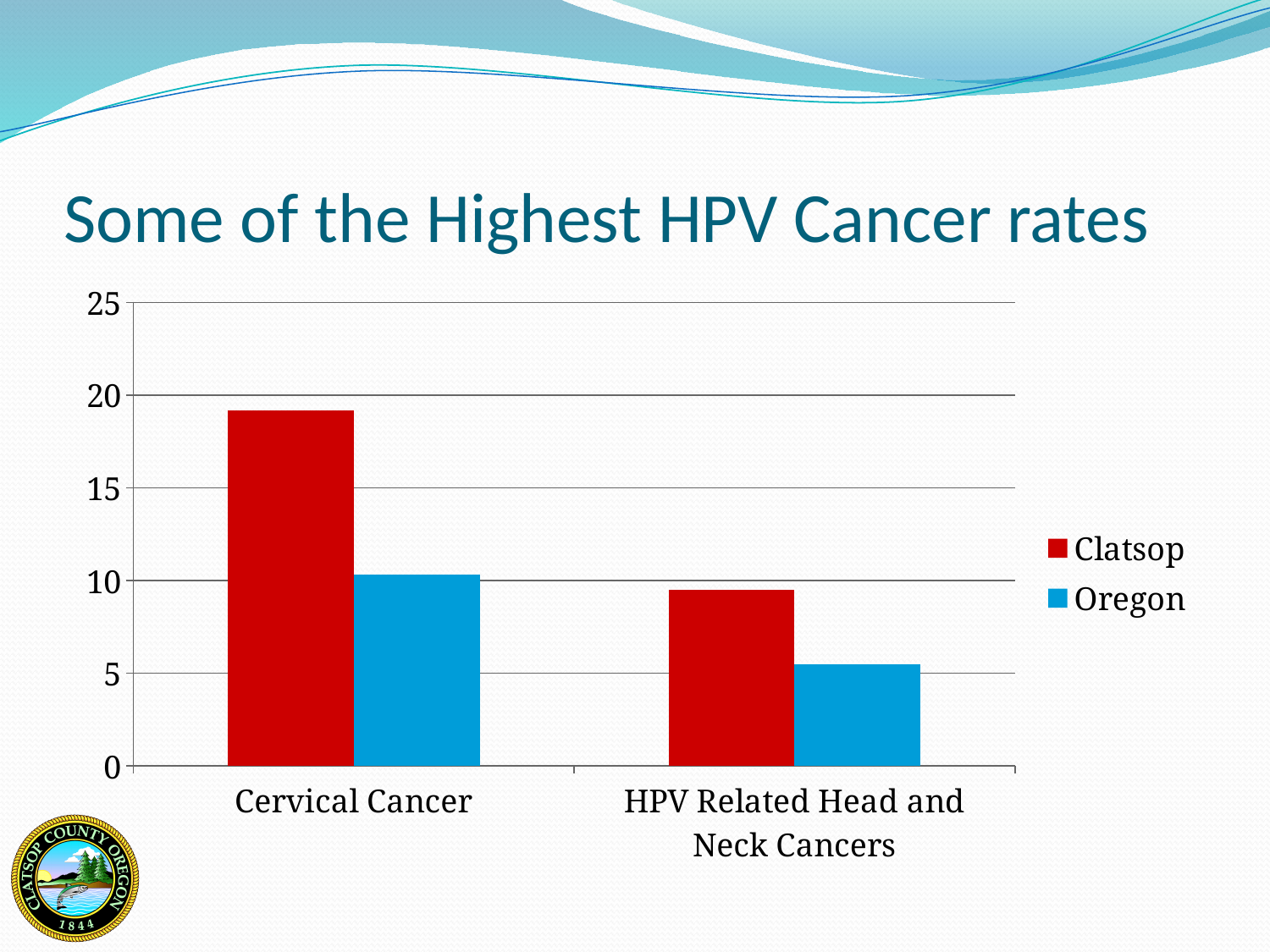
What is the title of the chart on the slide? Some of the Highest HPV Cancer rates Which category has the lowest Oregon value? HPV Related Head and Neck Cancers What kind of chart is shown on the slide? bar chart How many series does the legend list? 2 Is the Oregon value for HPV Related Head and Neck Cancers greater or less than 10? less Is the Oregon value for Cervical Cancer greater or less than 15? less Is the Clatsop value for Cervical Cancer greater or less than 15? greater Which series is shown in red? Clatsop Which is larger for Cervical Cancer, the Clatsop value or the Oregon value? Clatsop How many categories are shown on the x axis? 2 Which category has the highest Clatsop value? Cervical Cancer